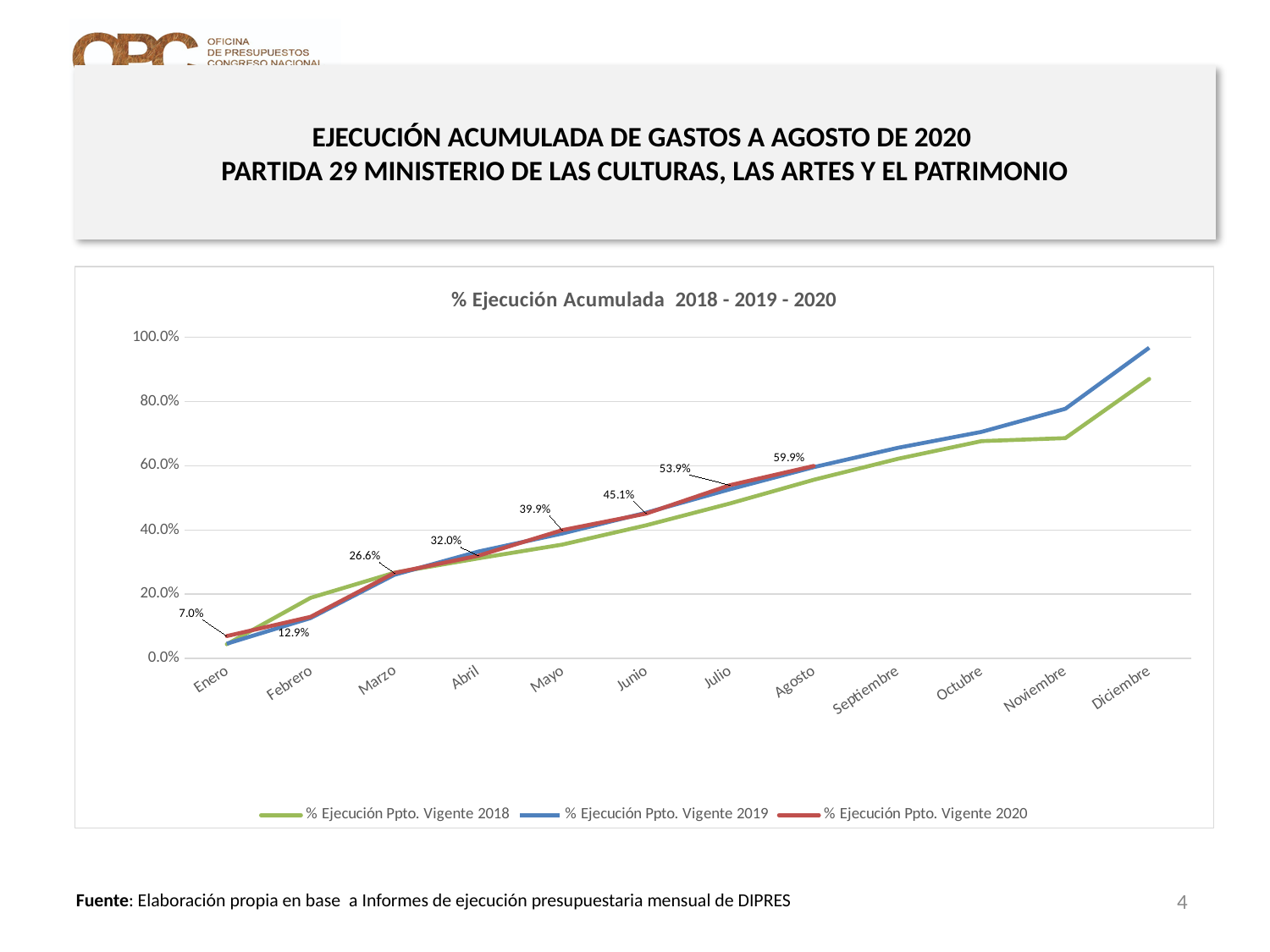
How many series does the legend list? 3 What is the value of % Ejecución Ppto. Vigente 2020 for Mayo? 39.9% What is the value of % Ejecución Ppto. Vigente 2020 for Enero? 7.0% What is the value of % Ejecución Ppto. Vigente 2020 for Agosto? 59.9% How many months are shown on the x axis? 12 Does the % Ejecución Ppto. Vigente 2020 series rise or fall from Enero to Agosto? rise What is the value of % Ejecución Ppto. Vigente 2020 for Marzo? 26.6% Is the value of % Ejecución Ppto. Vigente 2019 for Diciembre greater or less than 80.0%? greater What type of chart is shown on the slide? line chart What is the difference between the 2020 values for Febrero and Enero? 5.9% What is the difference between the 2020 values for Agosto and Julio? 6.0% Which series has the higher value in Diciembre, 2018 or 2019? % Ejecución Ppto. Vigente 2019